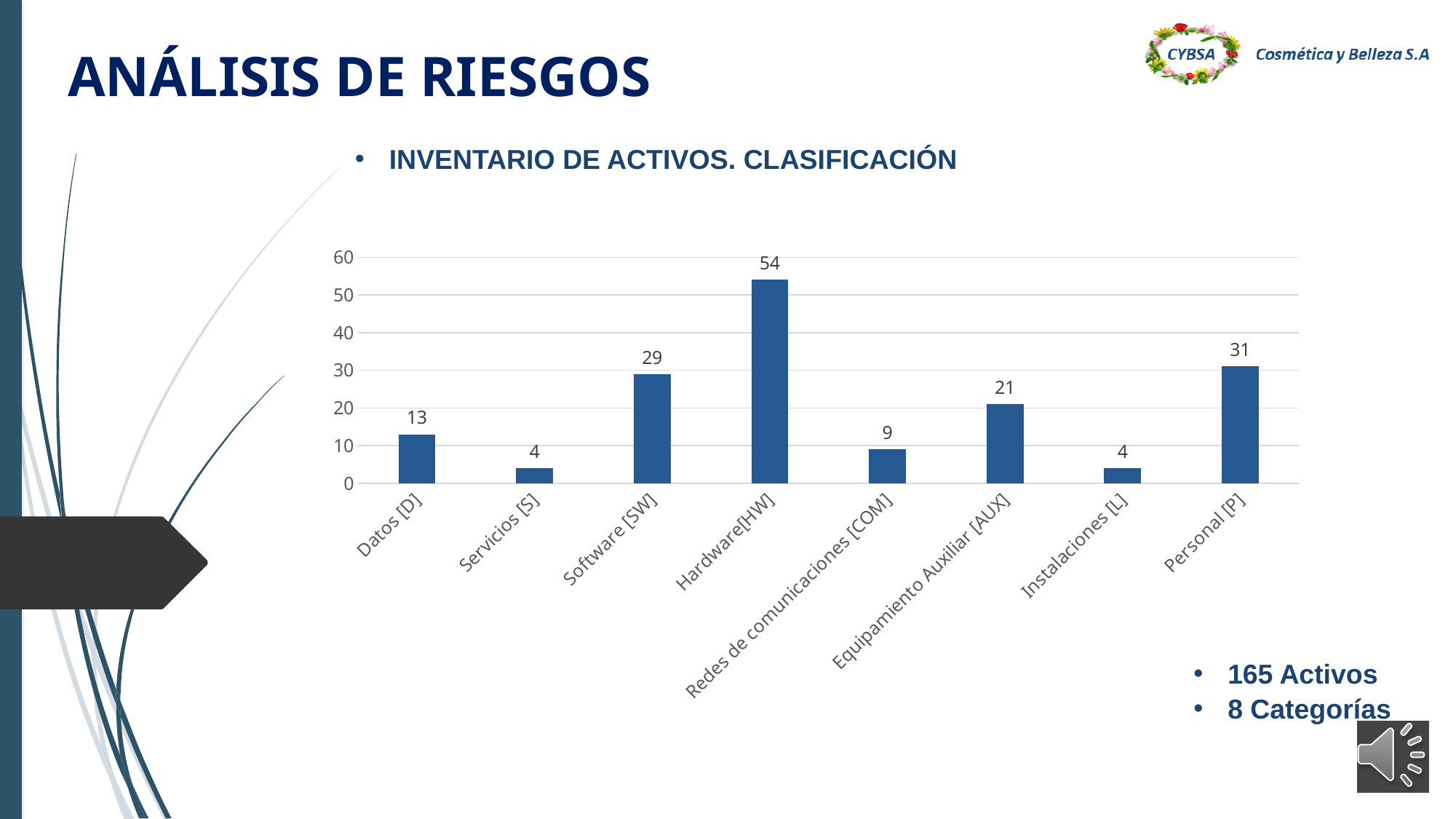
Is the value for Redes de comunicaciones [COM] greater or less than 10? less Which category has the highest value? Hardware[HW] What is the difference between the values for Hardware[HW] and Software [SW]? 25 What is the difference between the values for Personal [P] and Datos [D]? 18 What is the value for Equipamiento Auxiliar [AUX]? 21 What is the value for Software [SW]? 29 How many categories are shown on the x axis? 8 Which categories share the lowest value? Servicios [S] and Instalaciones [L] Which is larger, the value for Software [SW] or the value for Personal [P]? Personal [P] What is the value for Hardware[HW]? 54 What is the highest value shown on the y axis? 60 What kind of chart is shown on the slide? bar chart